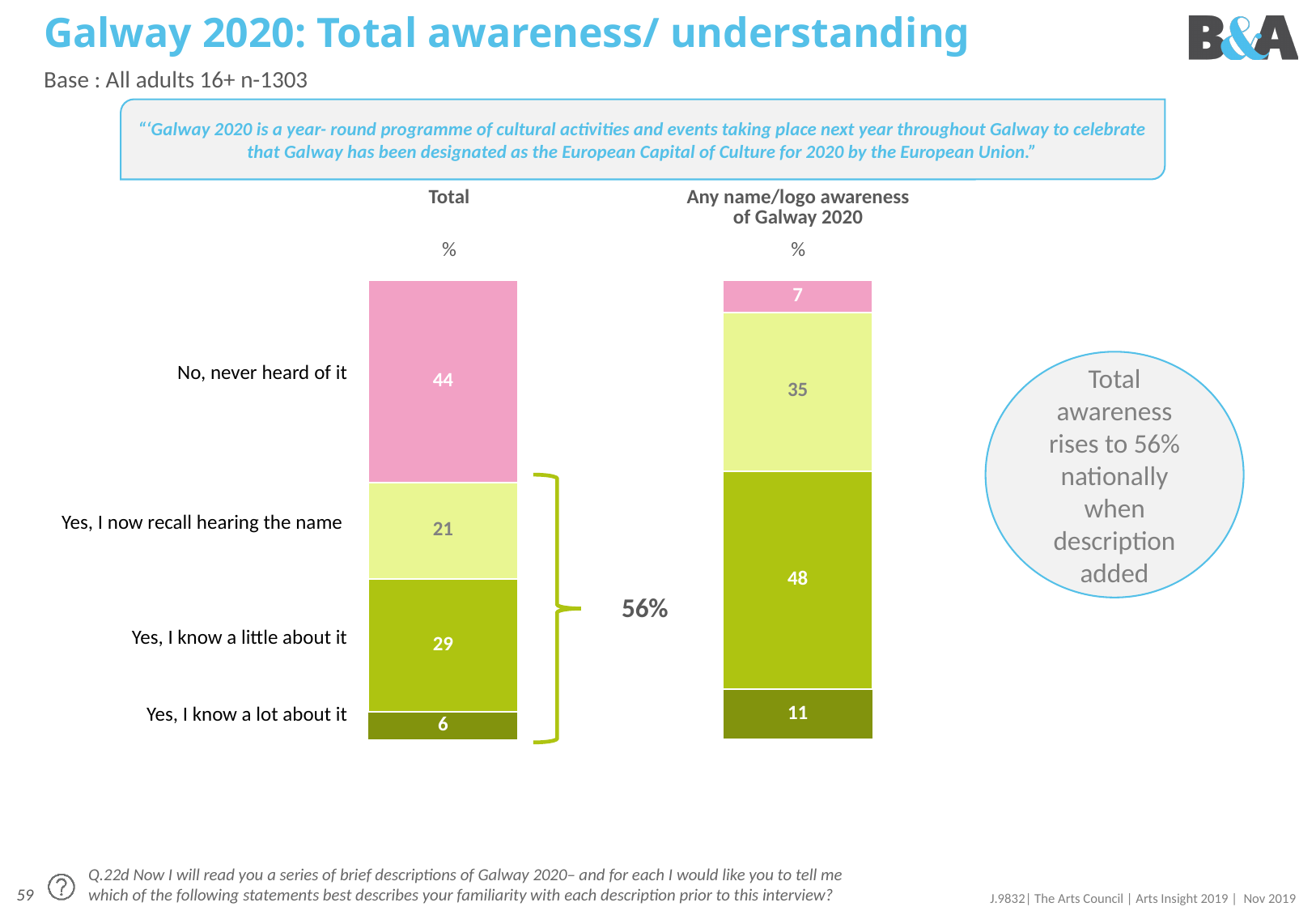
What is the difference between 'Yes, I know a little about it' in the Total column and in the 'Any name/logo awareness of Galway 2020' column? 19 Which response has the smallest share in the 'Any name/logo awareness of Galway 2020' column? No, never heard of it In the 'Any name/logo awareness of Galway 2020' column, what percentage said 'Yes, I know a little about it'? 48 In the 'Any name/logo awareness of Galway 2020' column, what percentage said 'No, never heard of it'? 7 Which is larger in the Total column: 'Yes, I now recall hearing the name' or 'Yes, I know a little about it'? Yes, I know a little about it What type of chart is shown on the slide? Stacked bar chart What is the combined percentage of the three 'Yes' responses in the 'Any name/logo awareness of Galway 2020' column? 94 Which response has the largest share in the Total column? No, never heard of it What total awareness percentage is indicated by the bracket next to the Total column? 56% What percentage of the Total column said 'No, never heard of it'? 44 How many response categories are shown in each stacked bar? 4 What percentage of the Total column said 'Yes, I know a lot about it'? 6